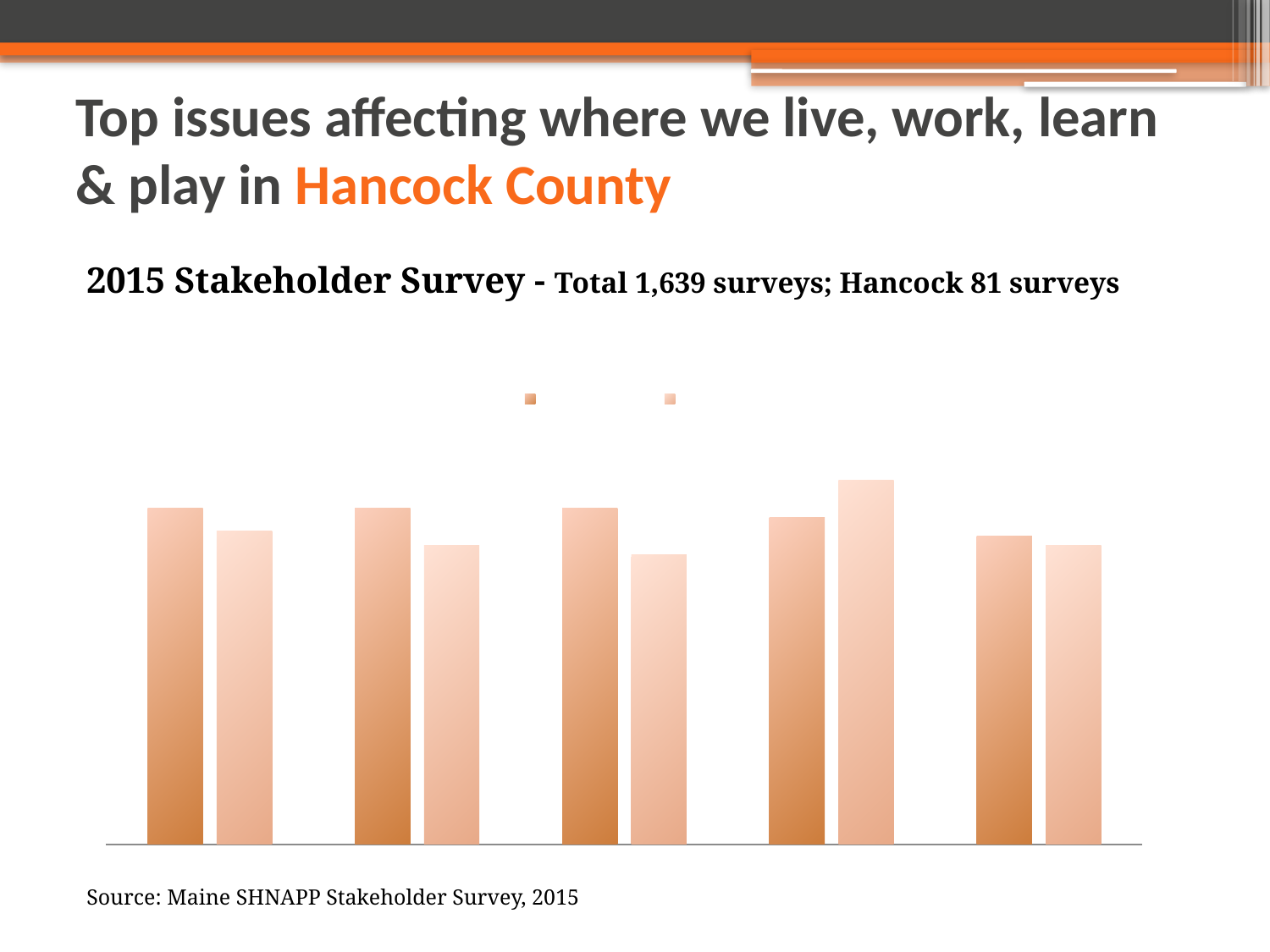
How many series does the chart's legend list? 2 Are the bars in the chart vertical or horizontal? vertical Which group of bars, counting from the left, contains the tallest bar in the chart? the fourth group In the first group of bars from the left, which bar is taller, the darker orange bar or the lighter orange bar? the darker orange bar In the third group of bars from the left, which bar is taller, the darker orange bar or the lighter orange bar? the darker orange bar In the fourth group of bars from the left, which bar is taller, the darker orange bar or the lighter orange bar? the lighter orange bar What kind of chart is shown on the slide? bar chart How many groups of bars are plotted in the chart? 5 How many bars are plotted in total in the chart? 10 What source is cited below the chart? Maine SHNAPP Stakeholder Survey, 2015